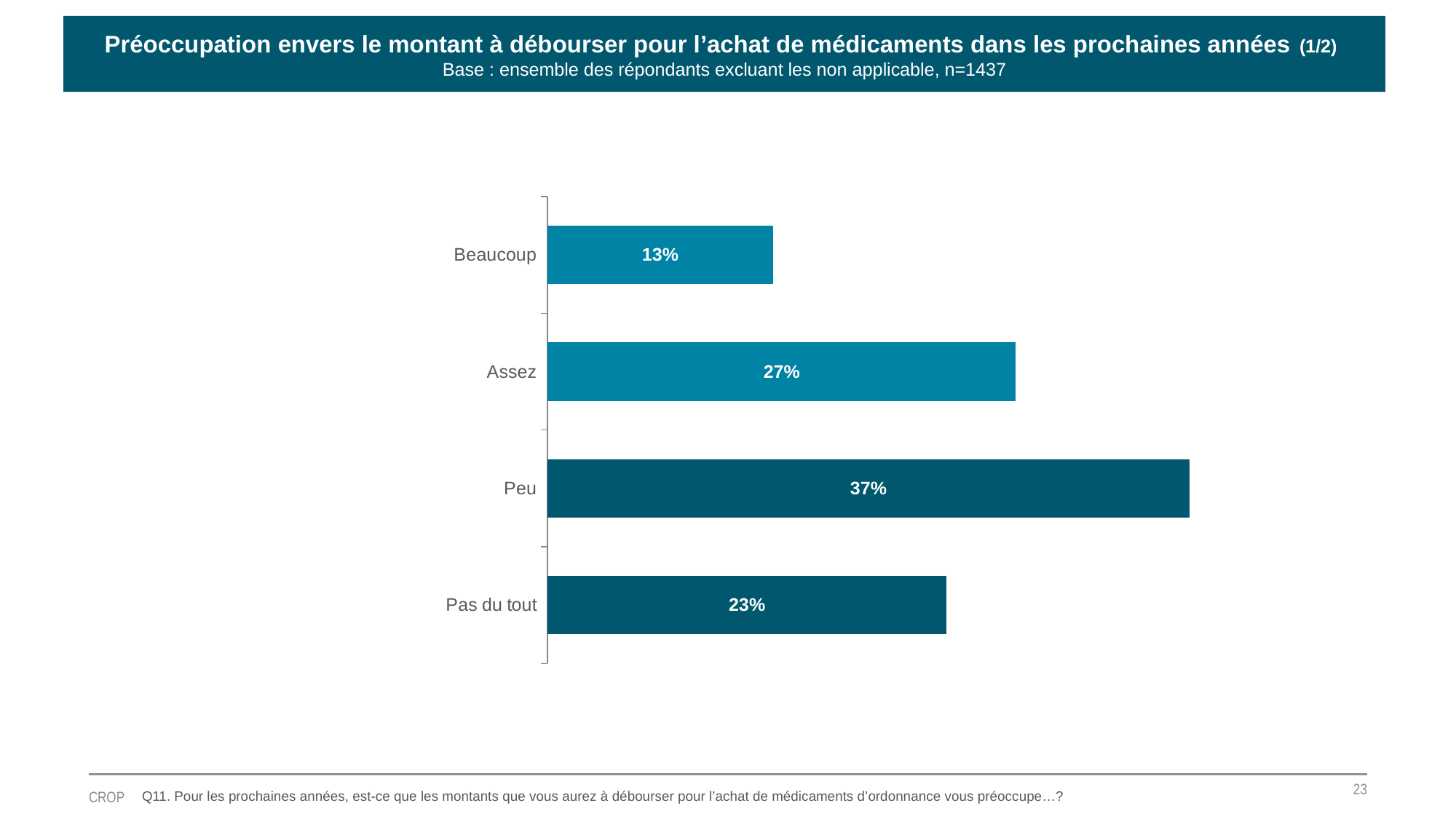
What is the value for Pas du tout? 23% How many categories are shown in the chart? 4 What is the value for Peu? 37% Which category has the lowest value? Beaucoup What is the difference between the values for Peu and Assez? 10% What is the difference between the values for Pas du tout and Beaucoup? 10% Which is larger, the value for Assez or the value for Pas du tout? Assez What kind of chart is shown on the slide? Bar chart What is the value for Beaucoup? 13% What is the value for Assez? 27% What is the base size (n) stated in the chart title? n=1437 Which category has the highest value? Peu